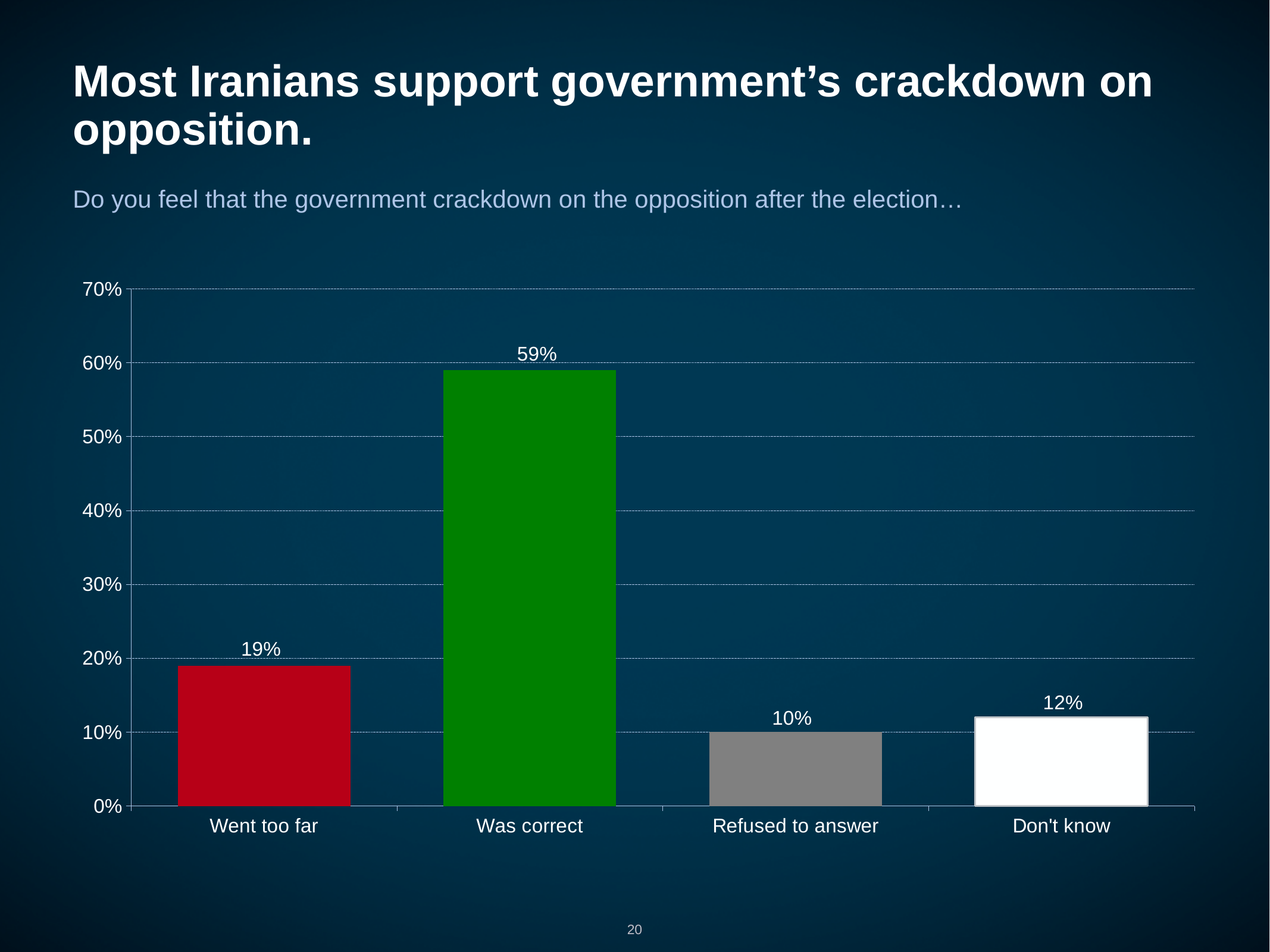
Which response category has the highest value? Was correct Which response category has the lowest value? Refused to answer What is the value for "Don't know"? 12% What percentage of respondents said the crackdown "Went too far"? 19% What percentage of respondents said the crackdown "Was correct"? 59% What is the difference between the "Was correct" and "Went too far" values? 40 percentage points What is the value for "Refused to answer"? 10% What colour is the bar for "Was correct"? Green Which is larger, the value for "Went too far" or the value for "Don't know"? Went too far What kind of chart is shown on the slide? Bar chart How many response categories are shown on the chart? 4 Is the value for "Was correct" greater or less than 50%? greater